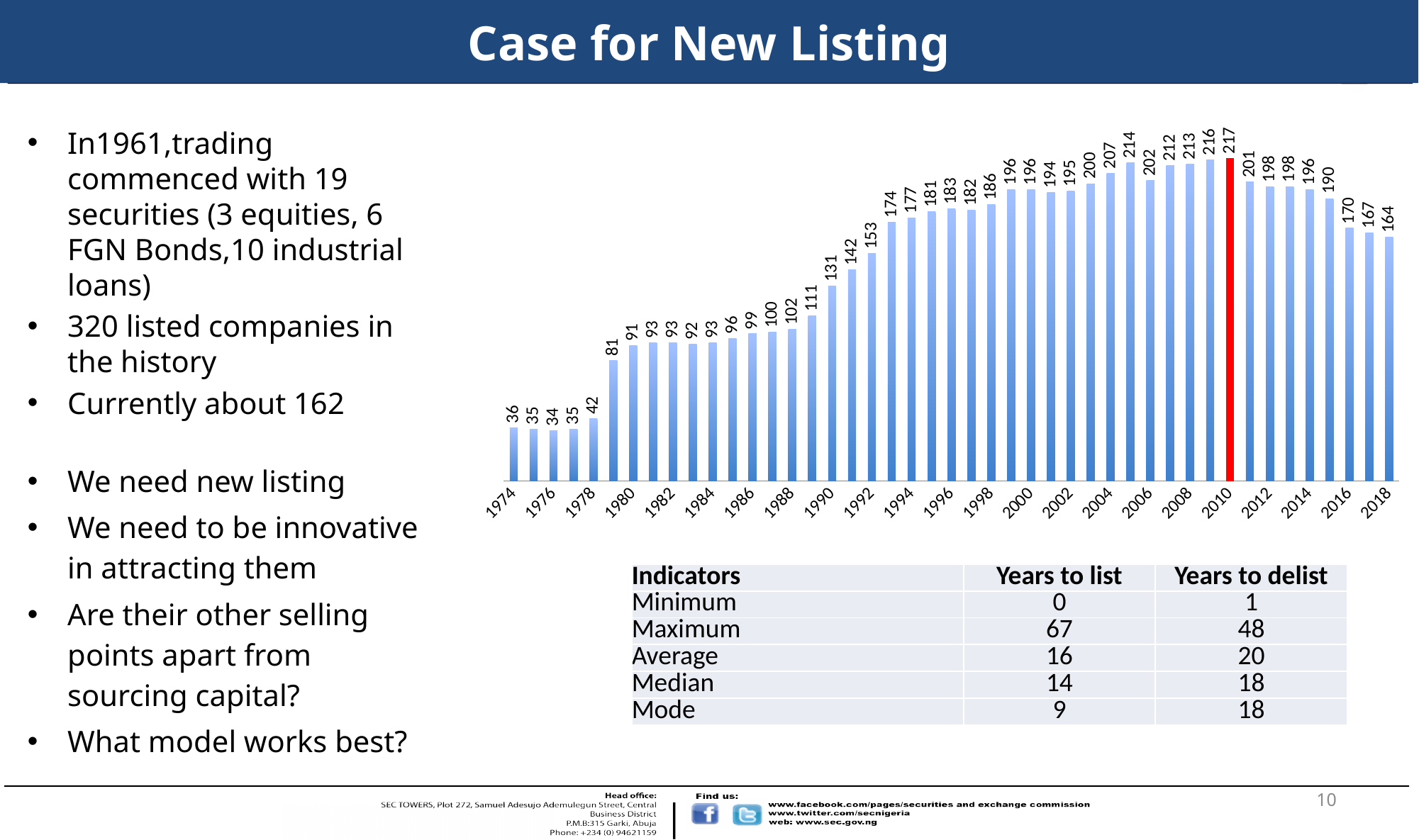
What is the value for 1974 on the chart? 36 Which year's bar is coloured red on the chart? 2010 What is the value for 2018 on the chart? 164 What kind of chart is shown on the slide? Bar chart How many bars are plotted on the chart? 45 What is the difference between the values for 2010 and 2018? 53 Which year has the lowest value on the chart? 1976 Which is larger, the value for 1990 or the value for 2000? 2000 What is the value for 1980 on the chart? 91 What is the value of the bar highlighted in red on the chart? 217 Which year has the highest value on the chart? 2010 What is the value for 2000 on the chart? 196